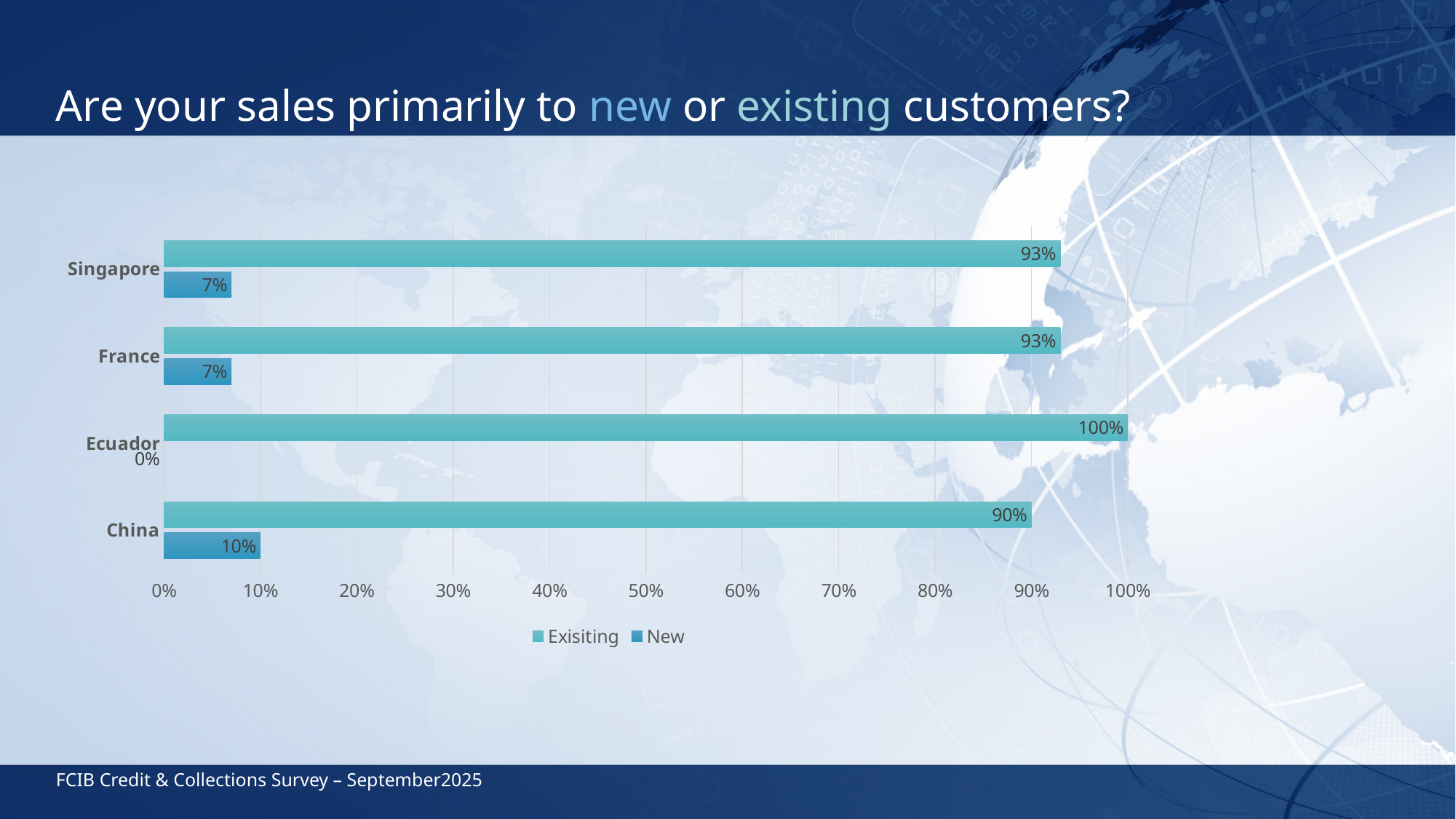
How many series does the legend list? 2 How many countries are shown on the chart? 4 What is the Exisiting value for Ecuador? 100% What is the Exisiting value for Singapore? 93% What is the New value for China? 10% What is the difference between the Exisiting and New values for China? 80% What kind of chart is shown on the slide? Bar chart Which country has the lowest New value? Ecuador What are the two series named in the legend? Exisiting and New Which country has the highest Exisiting value? Ecuador Which is larger, the New value for China or the New value for Singapore? China What is the New value for France? 7%